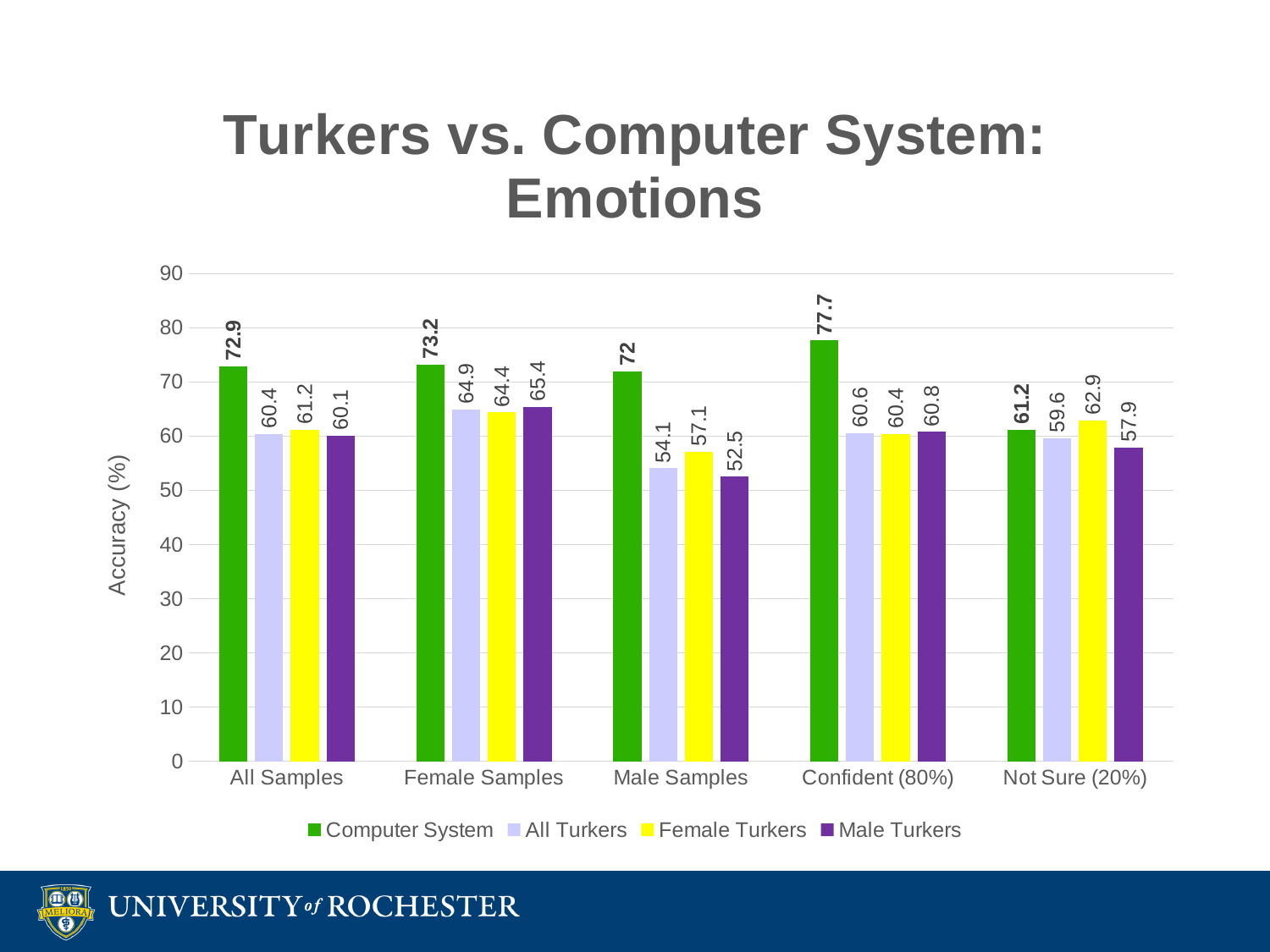
Which category has the highest Computer System accuracy? Confident (80%) Is the Computer System accuracy for Male Samples greater or less than 70? greater What is the Female Turkers accuracy for Not Sure (20%)? 62.9 How many series does the legend list? 4 What is the difference between the Computer System and All Turkers accuracy for Confident (80%)? 17.1 What is the Male Turkers accuracy for Male Samples? 52.5 What kind of chart is shown on the slide? Bar chart What is the label of the y axis? Accuracy (%) How many categories are shown on the x axis? 5 Which category has the lowest All Turkers accuracy? Male Samples For Female Samples, which is larger: Female Turkers or Male Turkers accuracy? Male Turkers What is the Computer System accuracy for All Samples? 72.9